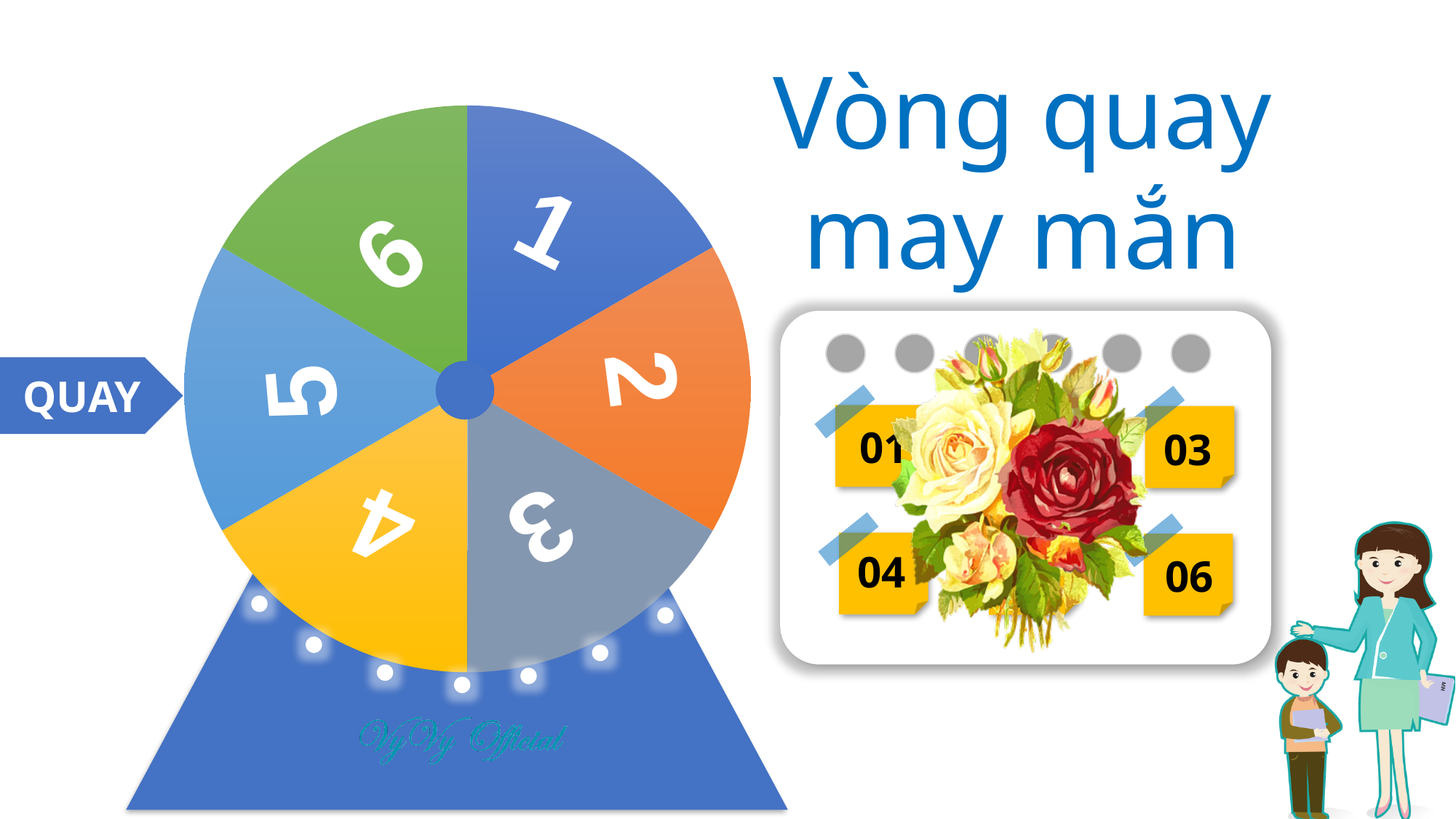
What kind of chart is the numbered wheel on the left of the slide? pie chart How many numbered segments does the wheel on the left of the slide have? 6 What is the title shown to the right of the wheel? Vòng quay may mắn Which number is on the green segment of the wheel? 6 What colour is the segment labelled 2 on the wheel? orange Which number is on the yellow segment of the wheel? 4